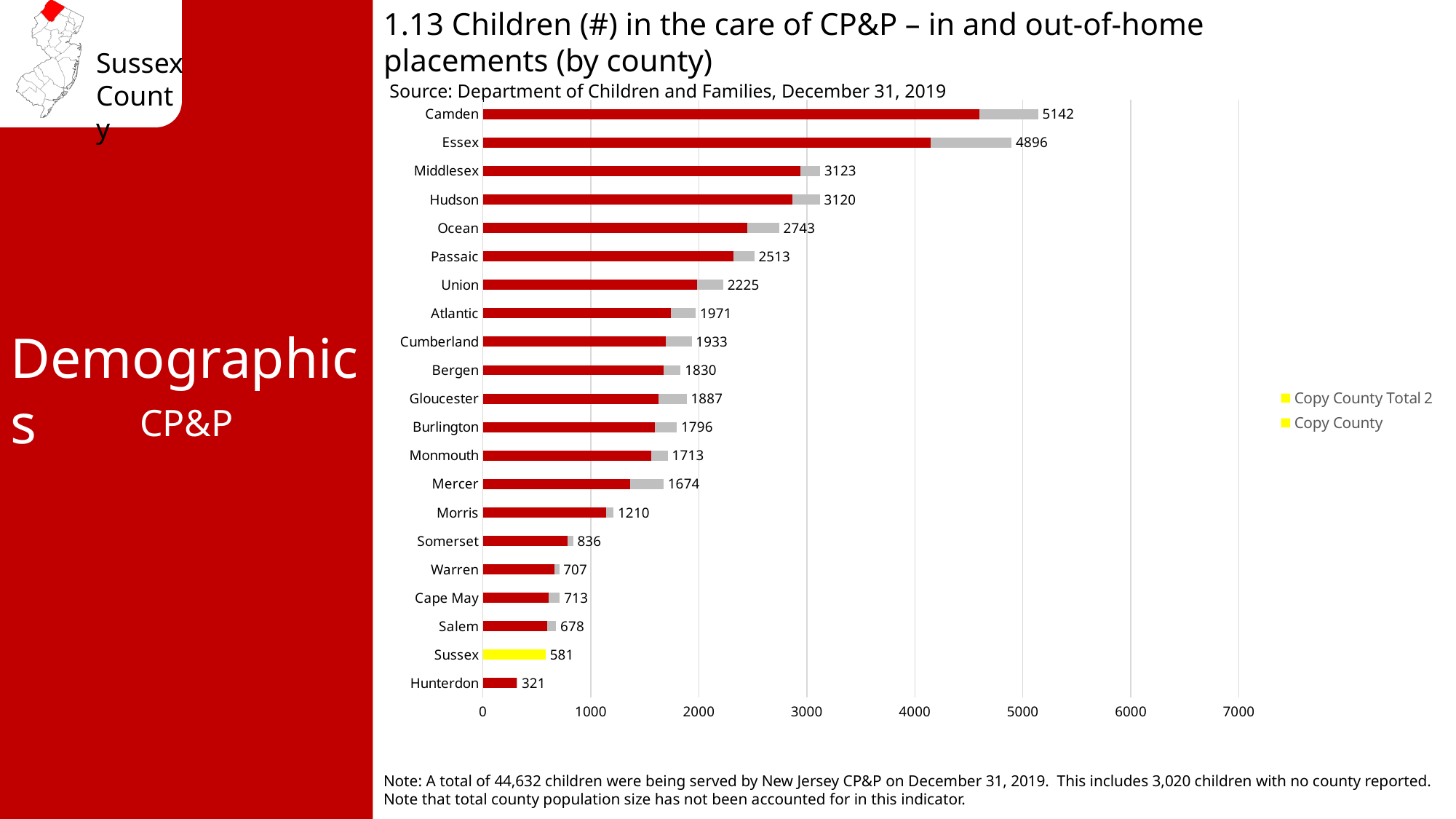
What is the difference between the totals for Sussex and Hunterdon? 260 What is the difference between the totals for Camden and Essex? 246 What type of chart is shown on the slide? Bar chart Which county has the highest total number of children in the care of CP&P? Camden Which county has the lowest total number of children in the care of CP&P? Hunterdon Which county has a larger total, Ocean or Passaic? Ocean What is the total number of children in the care of CP&P for Morris? 1210 How many counties are shown in the chart? 21 Is the total for Middlesex greater or less than 3000? greater What is the total number of children in the care of CP&P for Sussex? 581 How many entries does the legend list? 2 What is the total number of children in the care of CP&P for Camden? 5142